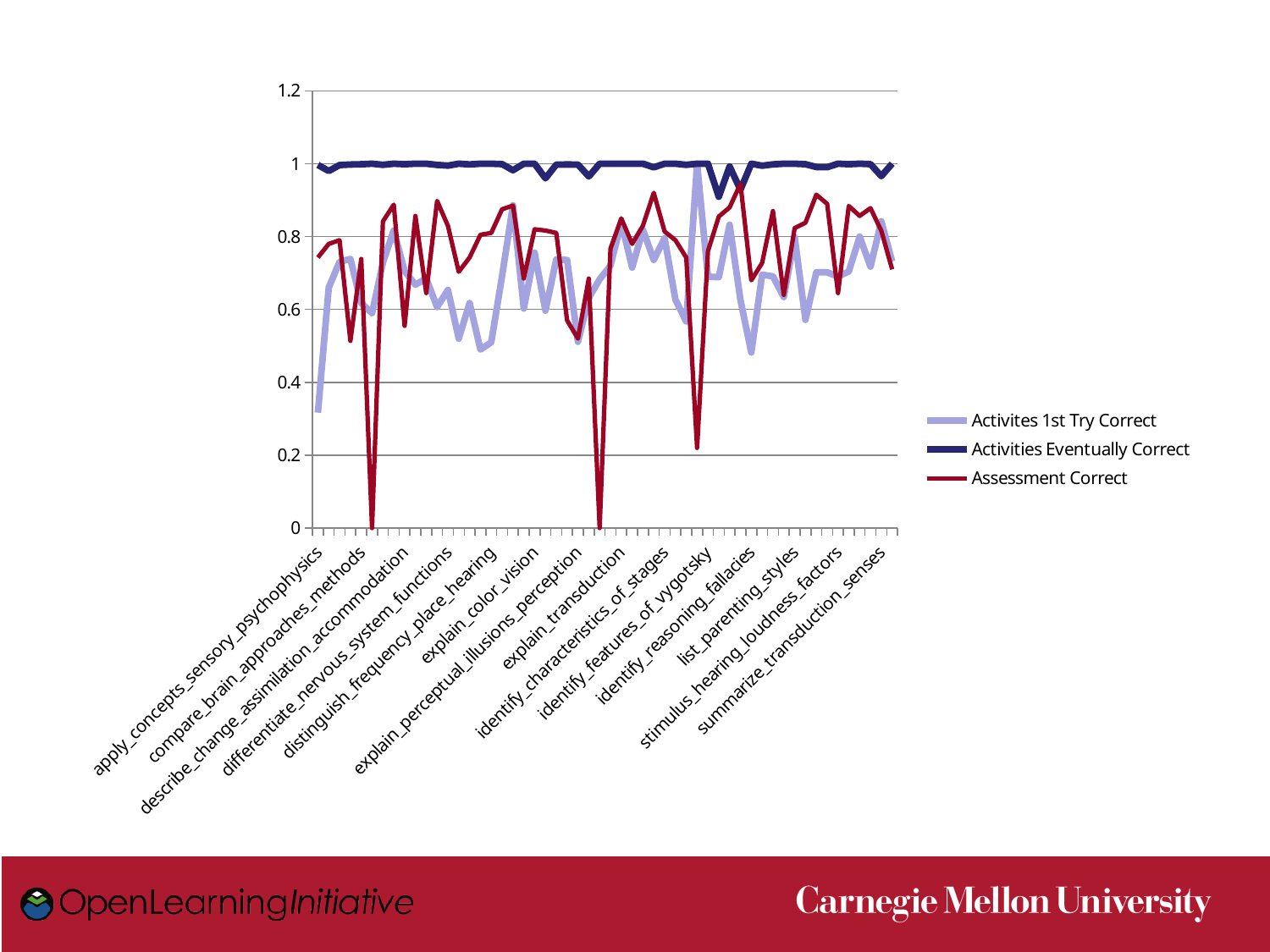
Is the value of Activites 1st Try Correct for apply_concepts_sensory_psychophysics greater or less than 0.4? less What is the highest value shown on the y axis? 1.2 Which series stays highest across almost all categories? Activities Eventually Correct Is the value of Assessment Correct for apply_concepts_sensory_psychophysics greater or less than 0.6? greater How many series does the legend list? 3 What is the lowest value reached by the Assessment Correct line? 0 What is the first category label on the x axis? apply_concepts_sensory_psychophysics Which series is drawn in dark navy blue? Activities Eventually Correct Is the value of Activities Eventually Correct for apply_concepts_sensory_psychophysics greater or less than 0.8? greater What kind of chart is shown on the slide? line chart Which series has the lowest value at the first category on the x axis? Activites 1st Try Correct For apply_concepts_sensory_psychophysics, which is larger: Assessment Correct or Activites 1st Try Correct? Assessment Correct